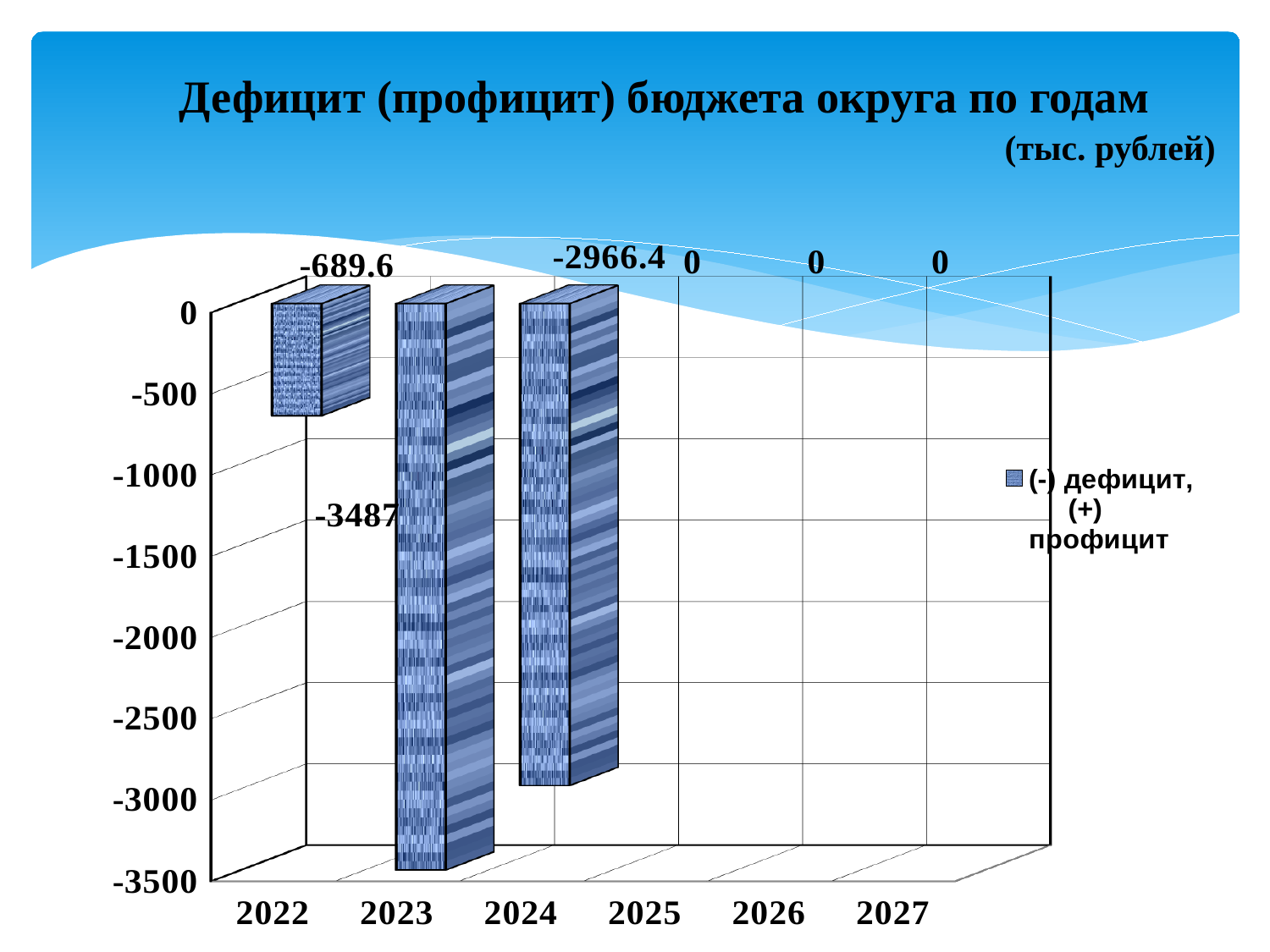
What is the difference between the values for 2022 and 2024? 2276.8 Which is larger, the value for 2022 or the value for 2024? 2022 What unit is given under the chart title? тыс. рублей What is the value for 2024? -2966.4 What is the value for 2026? 0 Which year has the lowest value (largest deficit)? 2023 What is the value for 2022? -689.6 What kind of chart is shown on the slide? bar chart What is the difference between the values for 2023 and 2024? 520.6 What is the value for 2023? -3487 How many years are shown on the x axis? 6 Is the value for 2023 greater or less than -3000? less